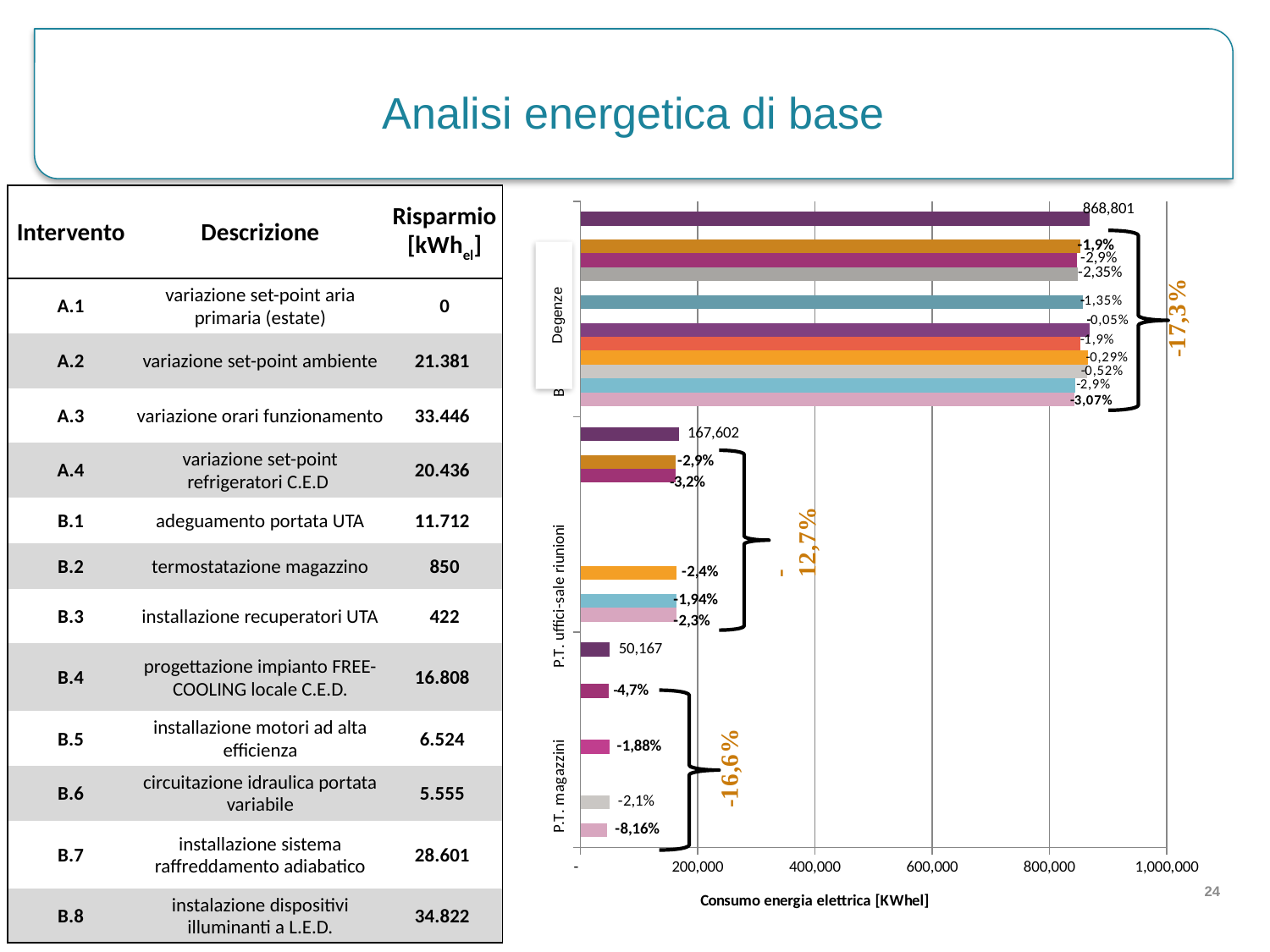
What overall percentage reduction is shown by the bracket for the Degenze group? -17,3% What is the baseline electricity consumption value labelled for the P.T. magazzini group? 50,167 Which group has the highest baseline electricity consumption? Degenze Is the baseline consumption for Degenze greater or less than 800,000? greater What is the difference between the baseline consumption of Degenze and P.T. uffici-sale riunioni? 701,199 What is the title of the x axis of the chart? Consumo energia elettrica [KWhel] What overall percentage reduction is shown by the bracket for the P.T. magazzini group? -16,6% What is the baseline electricity consumption value labelled for the P.T. uffici-sale riunioni group? 167,602 What type of chart is shown on the right of the slide? bar chart What is the largest single percentage reduction labelled in the P.T. magazzini group? -8,16% Which group has the lowest baseline electricity consumption? P.T. magazzini What is the baseline electricity consumption value labelled for the Degenze group? 868,801